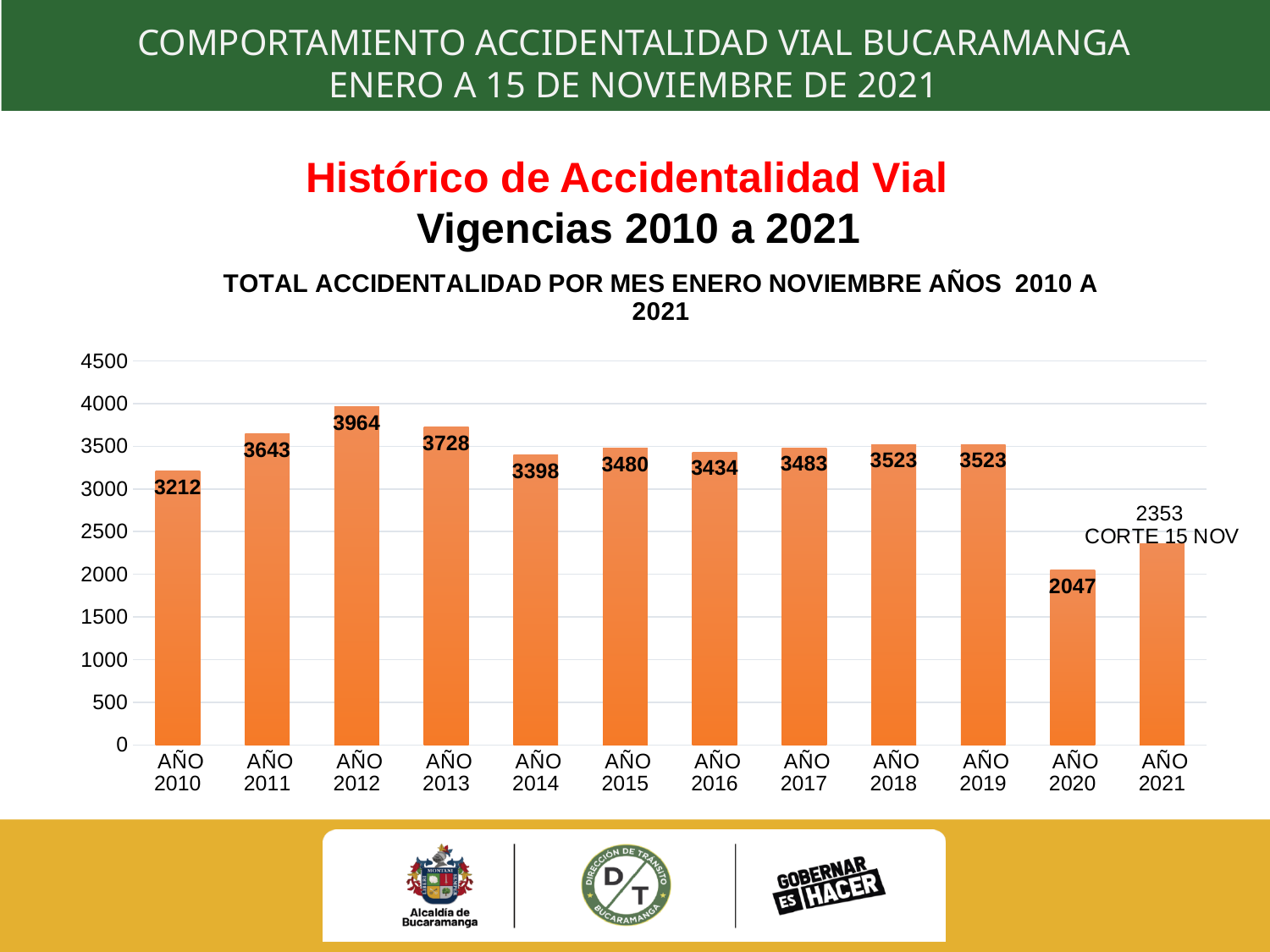
Which year has the highest value? AÑO 2012 What is the value for AÑO 2021? 2353 What kind of chart is this? bar chart Which year has the lowest value? AÑO 2020 Is the value for AÑO 2010 greater or less than 3000? greater What is the value for AÑO 2020? 2047 How many years are shown on the x axis? 12 Do the values rise or fall from AÑO 2019 to AÑO 2020? fall What note is printed next to the AÑO 2021 bar? CORTE 15 NOV What is the value for AÑO 2012? 3964 What is the difference between the values for AÑO 2012 and AÑO 2020? 1917 Which is larger, the value for AÑO 2013 or the value for AÑO 2014? AÑO 2013